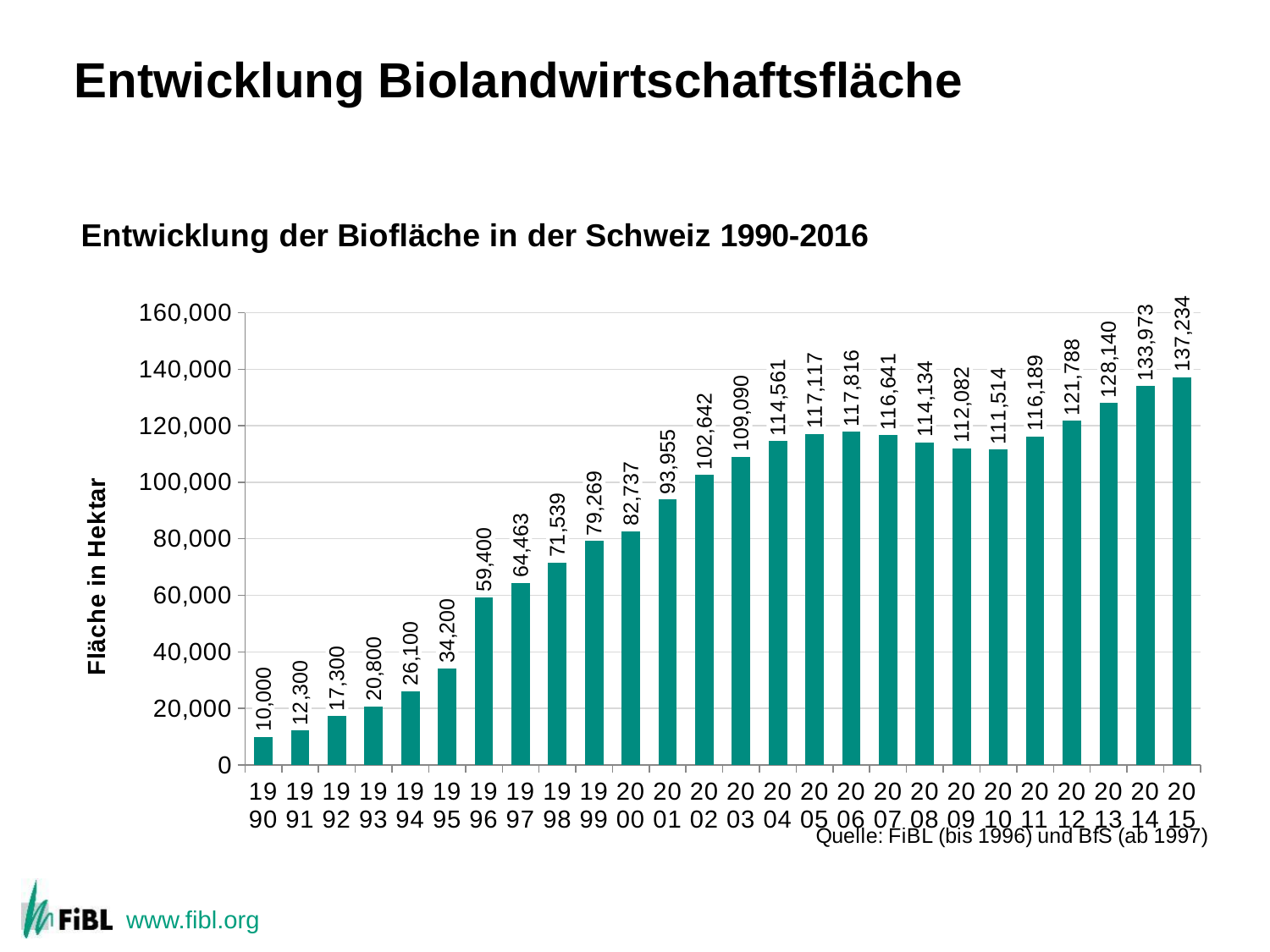
Which year has a larger value, 2006 or 2010? 2006 Is the value for 2002 greater or less than 100,000? greater What is the label of the vertical axis? Fläche in Hektar Which year has the highest organic farming area? 2015 What is the difference between the values for 1996 and 1995? 25,200 What type of chart is shown on the slide? Bar chart What is the value shown for 2006? 117,816 What is the organic farming area in hectares for 2015? 137,234 How many years (bars) are shown in the chart? 26 Which year has the lowest organic farming area? 1990 What is the difference between the values for 2015 and 2014? 3,261 What is the value shown for 1996? 59,400